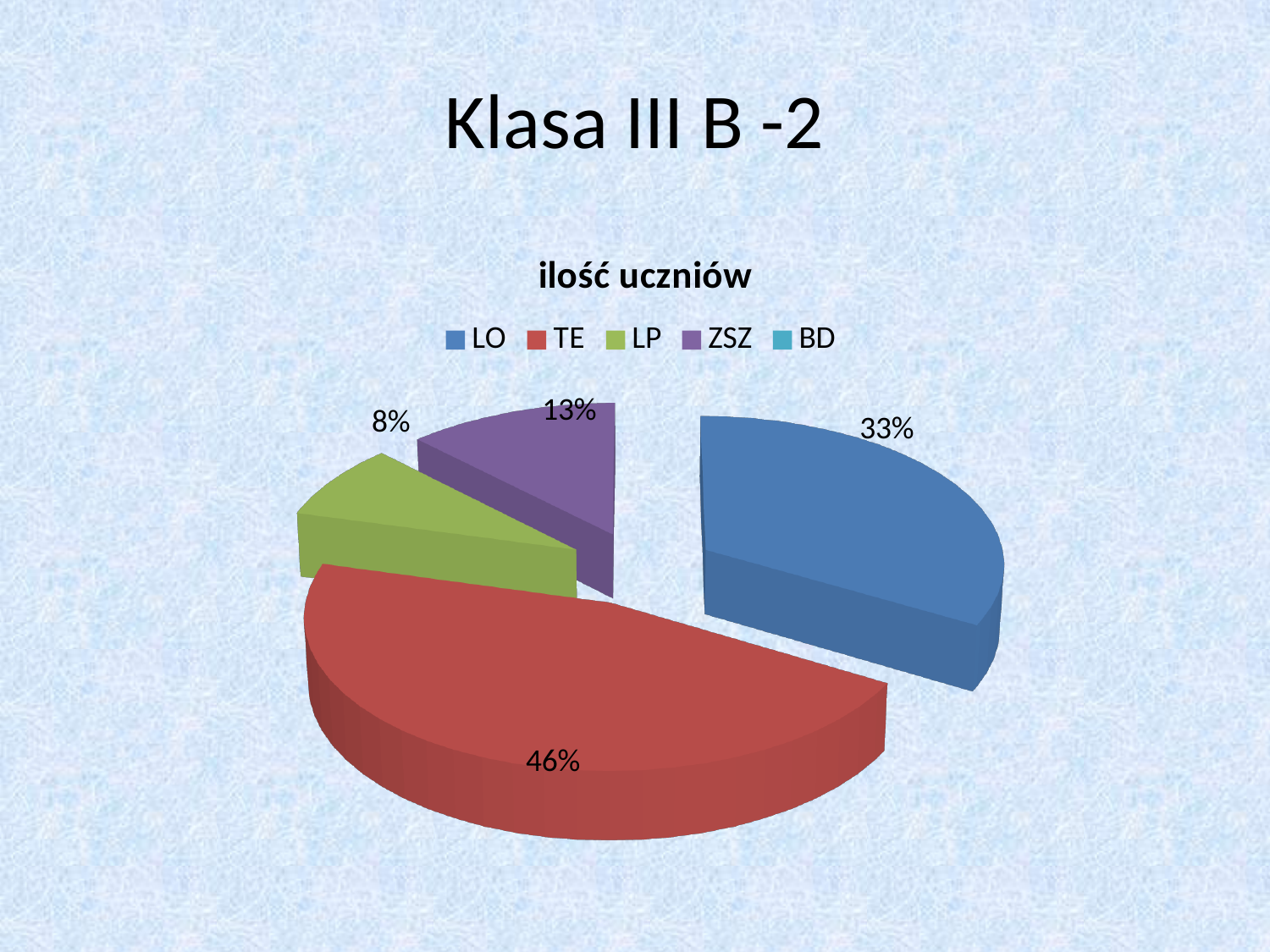
What percentage of the pie does TE account for? 46% What is the difference in percentage points between the TE slice and the LO slice? 13 What is the title of the chart? ilość uczniów What type of chart is shown on the slide? pie chart Which colour represents TE in the chart? red Which category has the largest slice of the pie? TE What is the difference in percentage points between the ZSZ slice and the LP slice? 5 Which is larger, the share for LO or the share for ZSZ? LO What percentage of the pie does LP account for? 8% What percentage of the pie does ZSZ account for? 13% How many entries does the chart legend list? 5